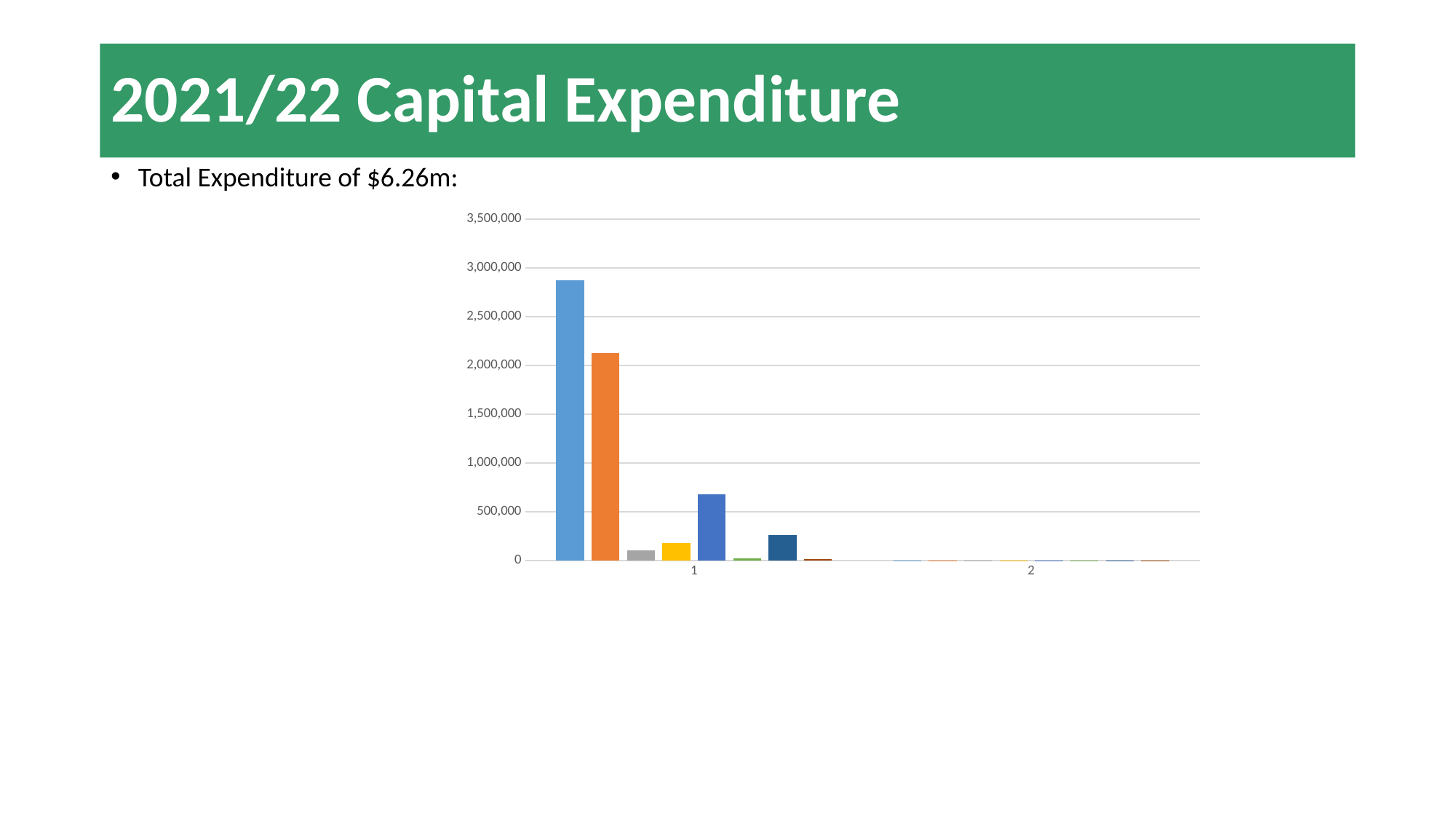
Is the value of the orange bar in category 1 greater or less than 2,000,000? greater Is the value of the dark blue bar (seventh bar) in category 1 greater or less than 500,000? less What is the highest value shown on the y axis of the chart? 3,500,000 How many categories are labelled on the x axis of the chart? 2 Which bar in category 1 is taller, the light blue bar or the orange bar? the light blue bar What kind of chart is shown on the slide? bar chart Which category has the larger bars overall, category 1 or category 2? category 1 Which colour bar is the tallest in category 1? light blue Is the value of the orange bar in category 1 greater or less than 2,500,000? less How many bars are plotted for category 1? 8